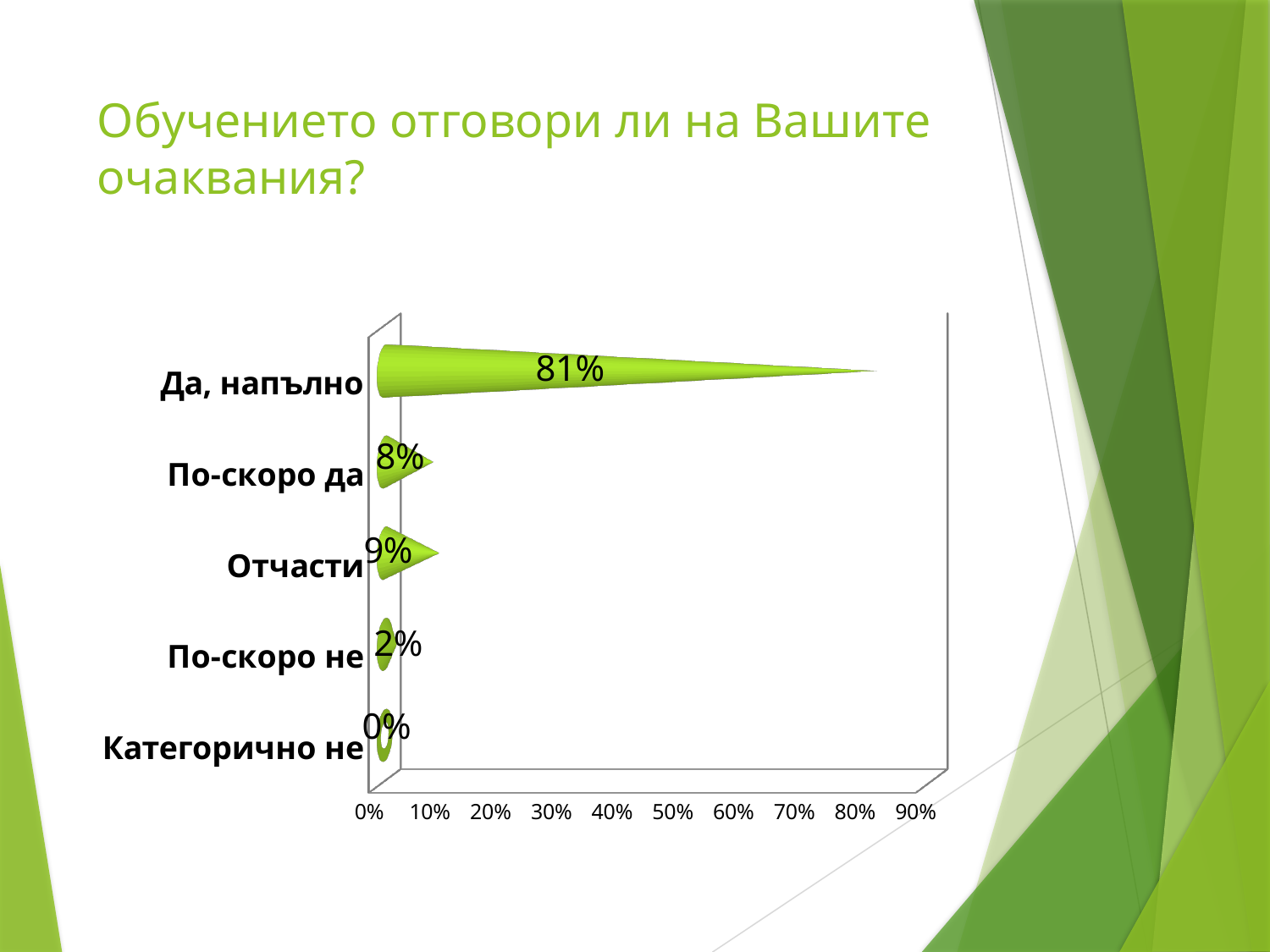
What is the value for "Да, напълно"? 81% What is the value for "Отчасти"? 9% Which is larger, the value for "Отчасти" or the value for "По-скоро да"? Отчасти Which category has the highest value? Да, напълно How many categories are shown in the chart? 5 What is the value for "По-скоро не"? 2% What is the value for "Категорично не"? 0% What is the difference between the values for "Да, напълно" and "Отчасти"? 72% What kind of chart is shown on the slide? Bar chart What is the title of the slide containing the chart? Обучението отговори ли на Вашите очаквания? What is the value for "По-скоро да"? 8% Which category has the lowest value? Категорично не